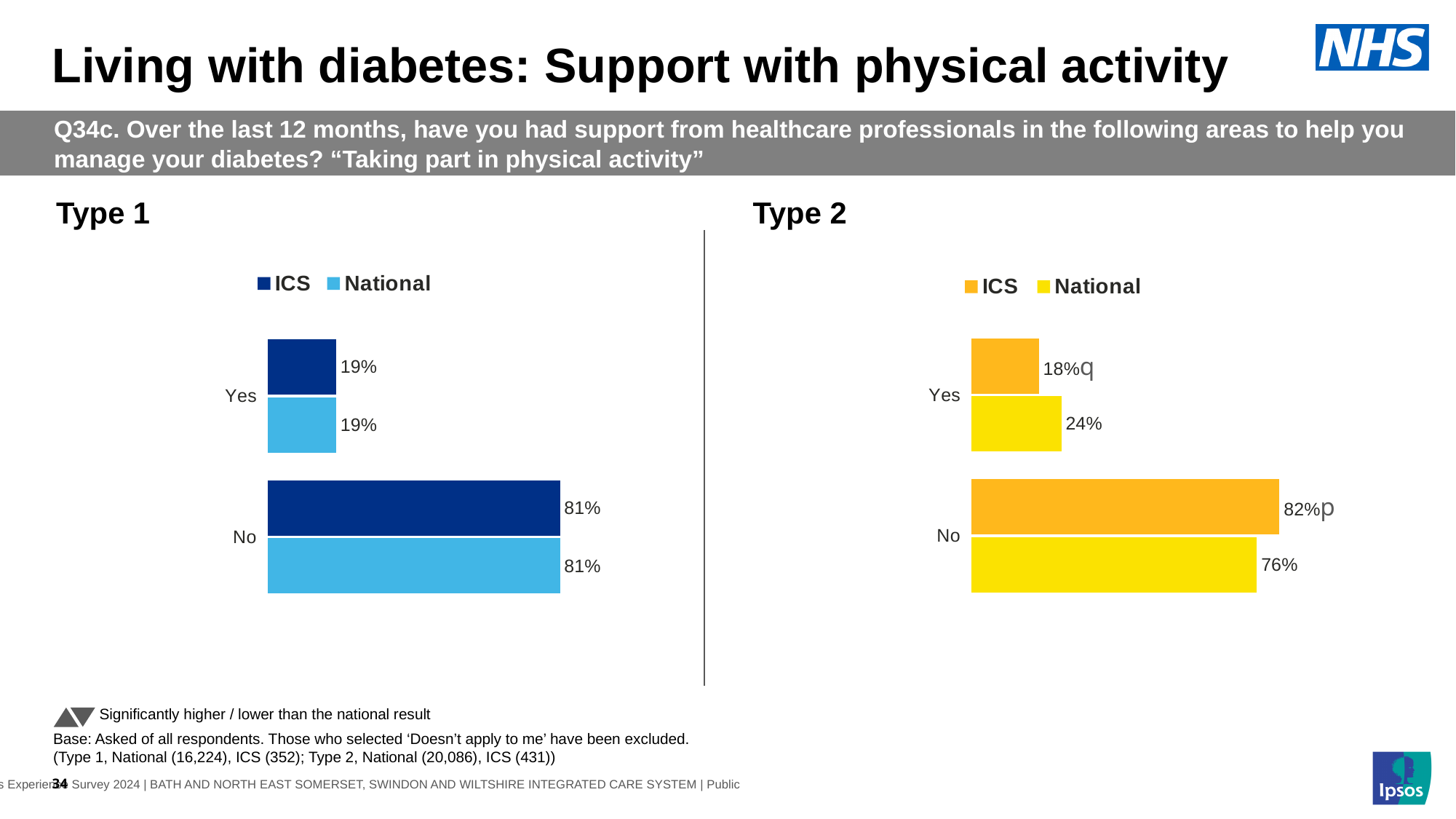
In the Type 2 chart, what is the ICS value for "Yes"? 18% How many series does the legend of the Type 1 chart list? 2 In the Type 2 chart, what is the National value for "Yes"? 24% What kind of chart is the Type 2 chart? Bar chart In the Type 1 chart, which category has the highest ICS value? No In the Type 2 chart, which category has the lowest National value? Yes In the Type 2 chart, which is larger for "Yes": the ICS value or the National value? National In the Type 2 chart, what is the ICS value for "No"? 82% In the Type 2 chart, what is the difference between the ICS and National values for "No"? 6% In the Type 1 chart, what is the ICS value for "Yes"? 19% In the Type 1 chart, what is the National value for "No"? 81% In the Type 2 chart, what is the National value for "No"? 76%